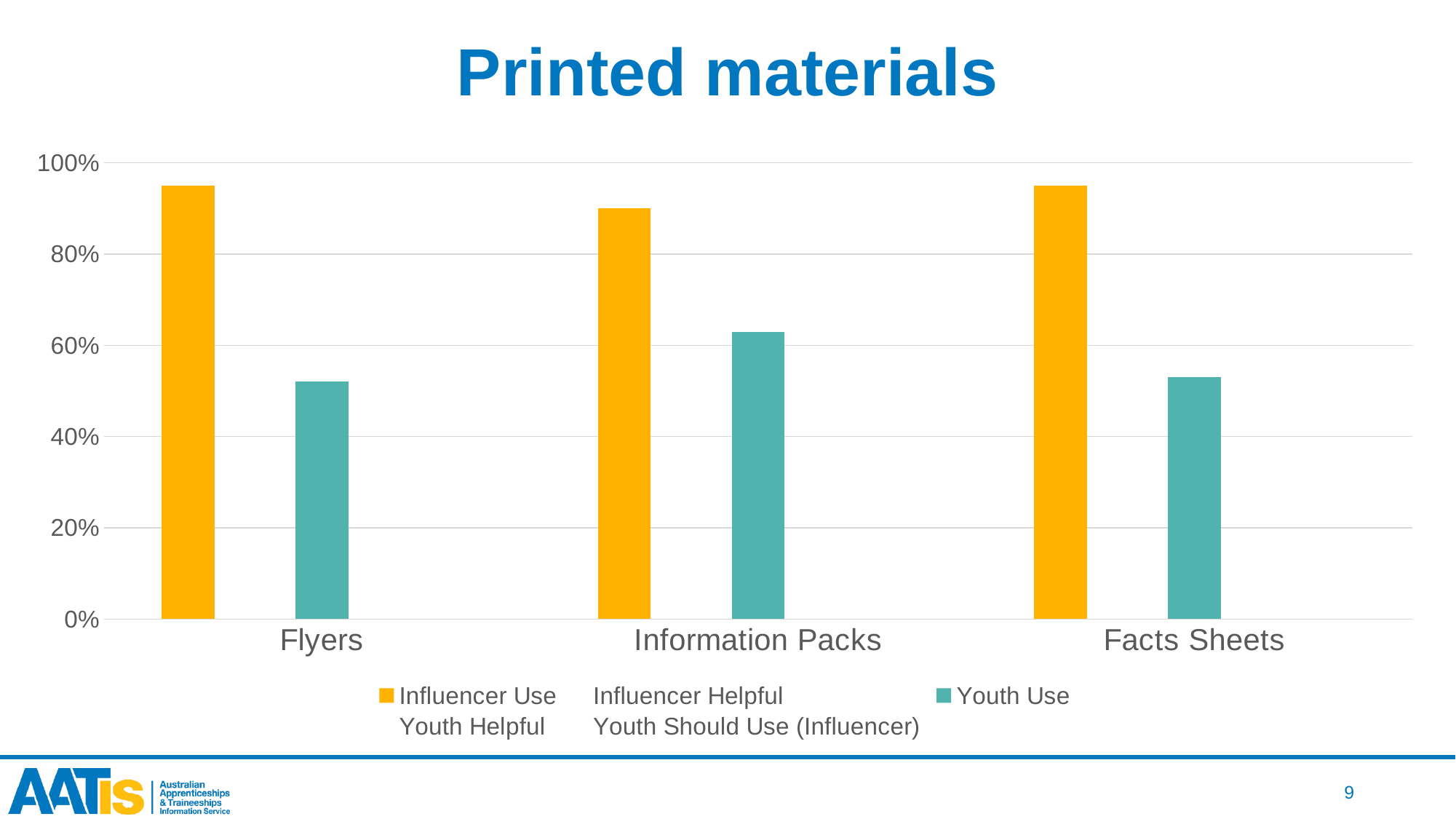
Which category has the highest Youth Use value? Information Packs Is the Youth Use value for Facts Sheets greater or less than 60%? less What is the title of the chart? Printed materials What colour are the Influencer Use bars? Orange Is the Youth Use value for Information Packs greater or less than 60%? greater How many categories are shown on the x axis? 3 For Information Packs, which is larger: Influencer Use or Youth Use? Influencer Use Is the Youth Use value for Flyers greater or less than 60%? less Which category has the lowest Influencer Use value? Information Packs What kind of chart is shown on the slide? Bar chart